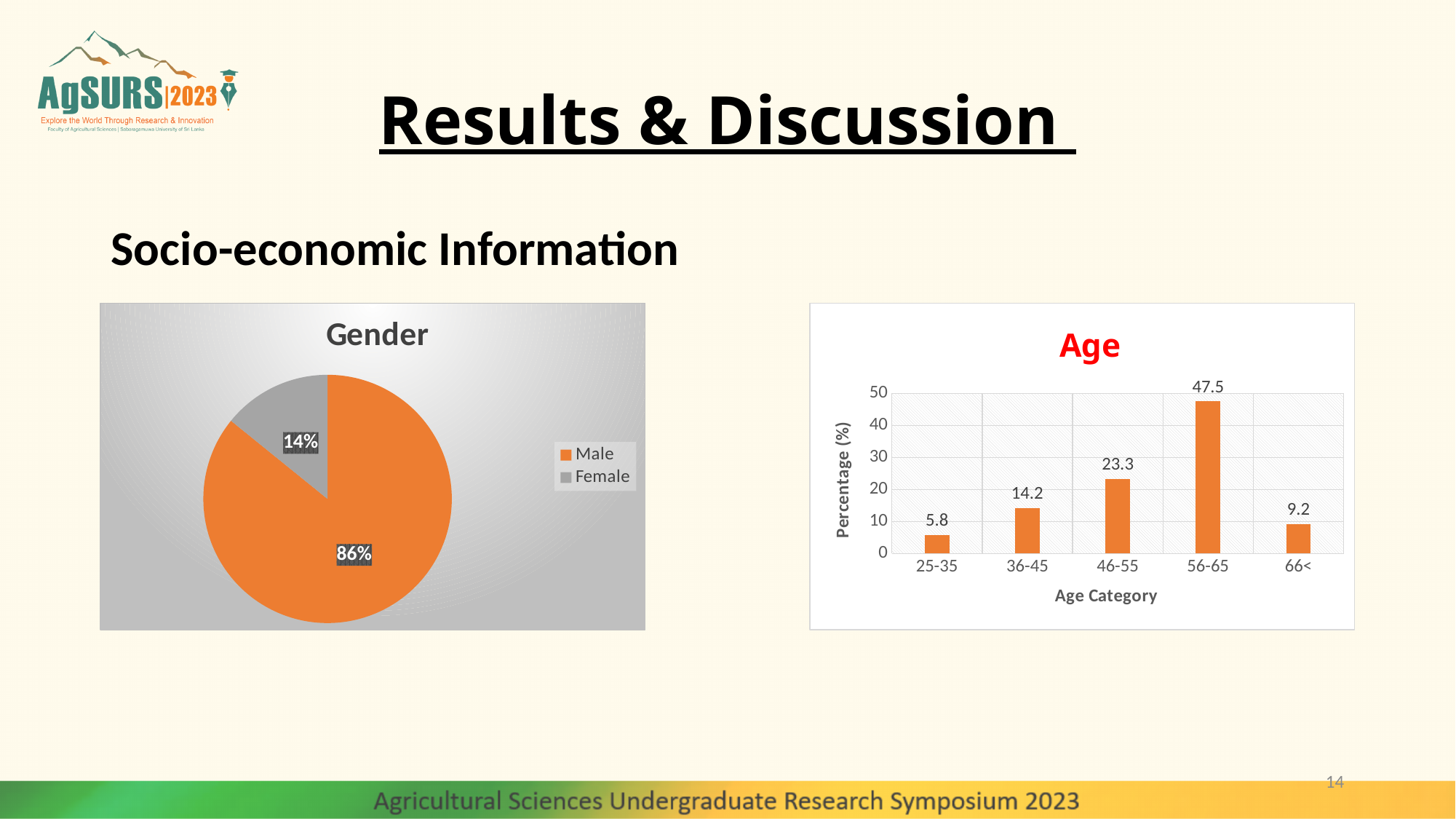
In the Age chart, which has a larger percentage, 36-45 or 66<? 36-45 In the Age chart, what is the percentage for the 25-35 age category? 5.8 How many age categories are shown in the Age chart? 5 In the Age chart, which age category has the lowest percentage? 25-35 What kind of chart is the Gender chart? Pie chart In the Gender chart, what share of respondents are Female? 14% What kind of chart is the Age chart? Bar chart In the Age chart, what is the difference between the percentages for 56-65 and 46-55? 24.2 In the Age chart, which age category has the highest percentage? 56-65 How many categories does the Gender chart's legend list? 2 In the Gender chart, what share of respondents are Male? 86% In the Age chart, what is the percentage for the 56-65 age category? 47.5